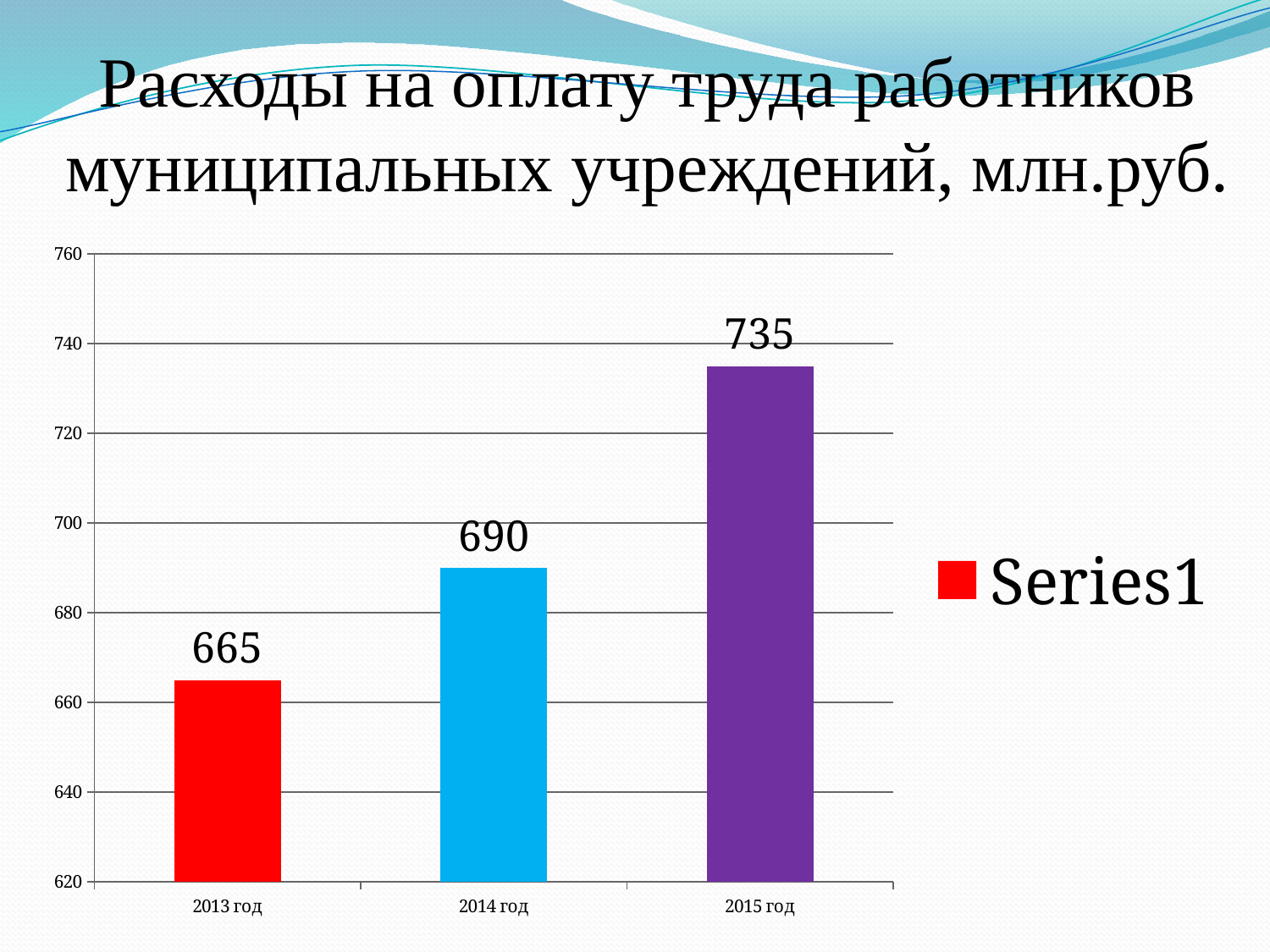
Which is larger, the value for 2014 год or the value for 2015 год? 2015 год Is the value for 2014 год greater or less than 700? less Do the values rise or fall from 2013 год to 2015 год? rise What is the value for 2013 год? 665 What is the difference between the values for 2014 год and 2013 год? 25 What kind of chart is shown on the slide? bar chart Which year has the highest value? 2015 год What is the value for 2015 год? 735 What is the difference between the values for 2015 год and 2013 год? 70 What is the value for 2014 год? 690 Which year has the lowest value? 2013 год How many categories are shown on the x axis? 3